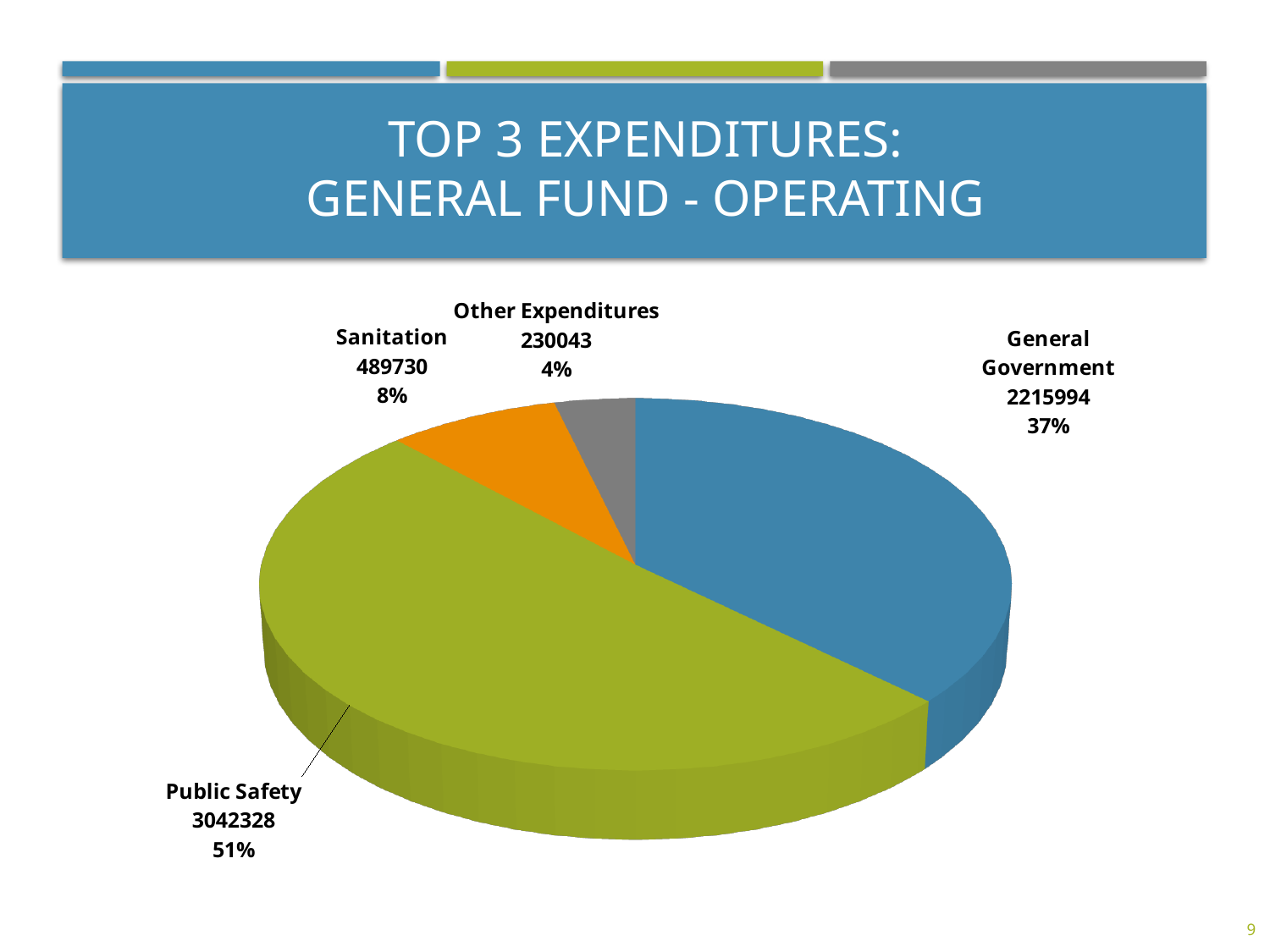
What is the value for General Government? 2215994 How many slices does the pie chart have? 4 Which category has the smallest share of the pie? Other Expenditures What type of chart is shown on the slide? pie chart What is the value for Other Expenditures? 230043 What is the difference between the values for Public Safety and General Government? 826334 What is the value for Sanitation? 489730 Which category has the largest share of the pie? Public Safety Which is larger, the value for Sanitation or the value for Other Expenditures? Sanitation What share of the pie does Sanitation represent? 8% What share of the pie does General Government represent? 37% What is the value for Public Safety? 3042328